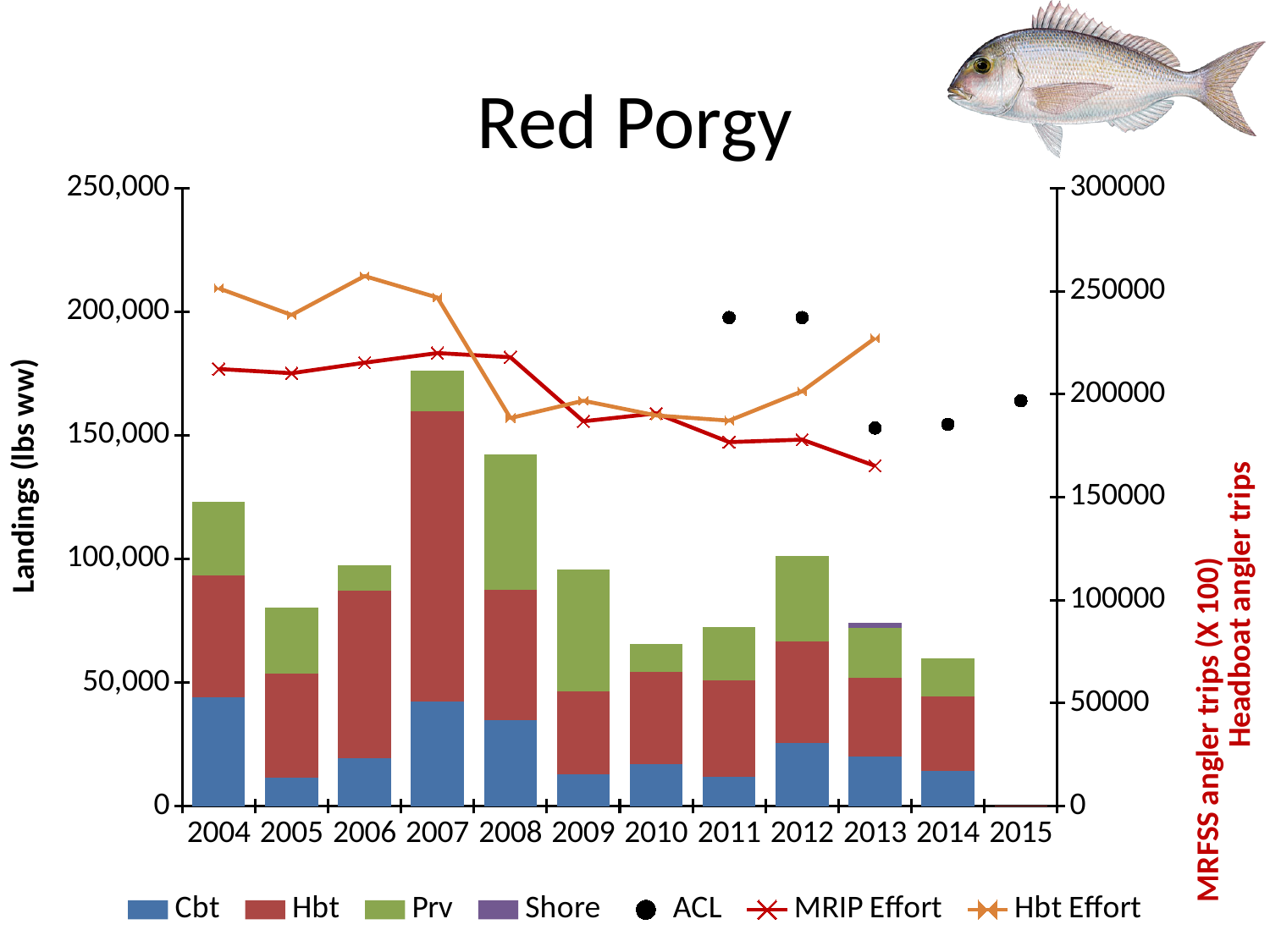
How many years are shown on the x axis? 12 Which year has the tallest stacked landings bar? 2007 Is the total landings bar for 2007 greater or less than 150,000? greater Which is larger, the ACL value for 2011 or for 2013? 2011 Is the total landings bar for 2010 greater or less than 100,000? less How many series does the legend list? 7 Does the MRIP Effort line generally rise or fall from 2004 to 2013? fall Which year has the lowest MRIP Effort value? 2013 Is the total landings bar for 2014 greater or less than 50,000? greater Which year has the highest Hbt Effort value? 2006 What kind of chart is this? Combined stacked bar and line chart What is the title of the chart? Red Porgy